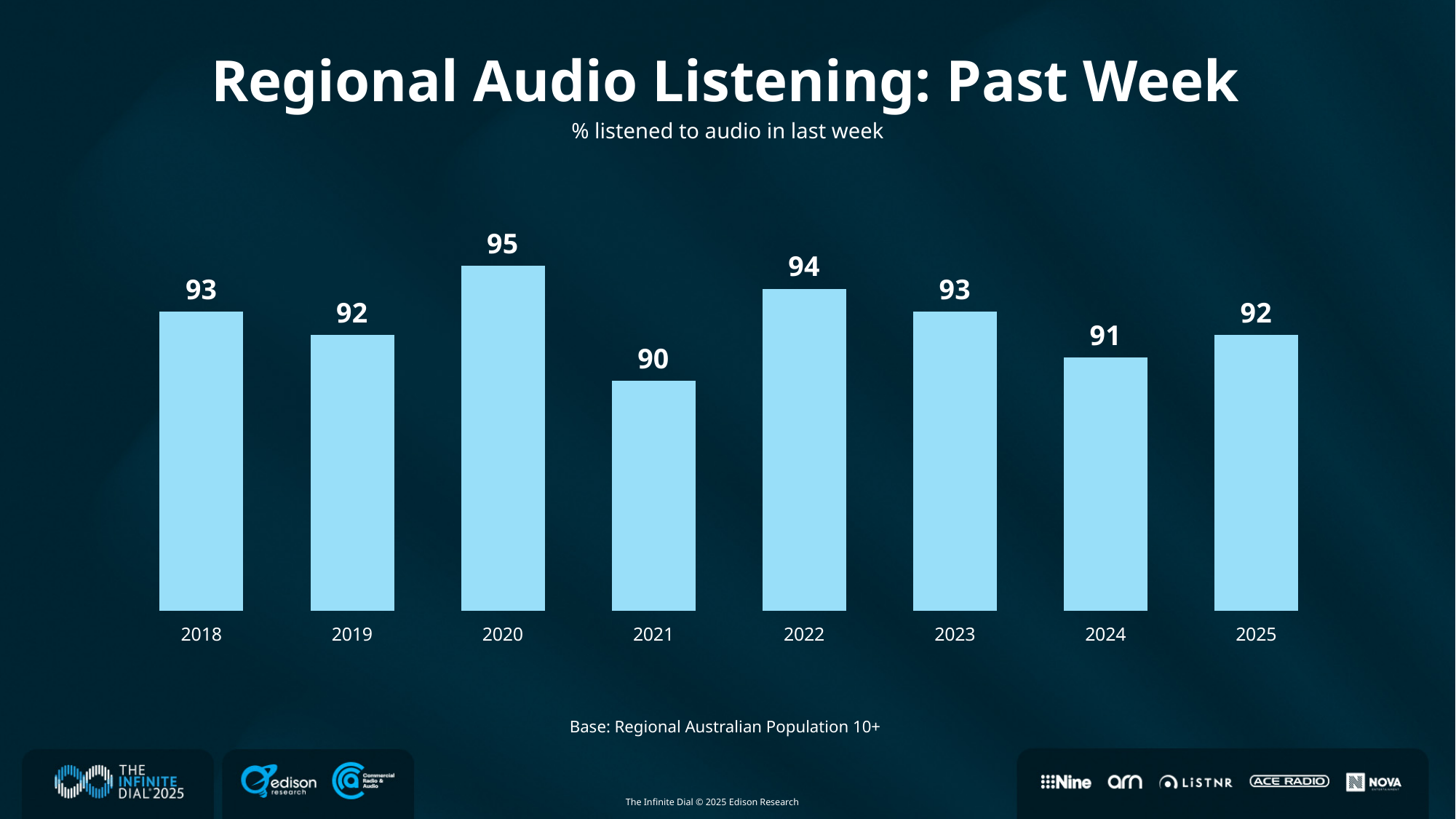
What is the base population stated below the chart? Regional Australian Population 10+ What is the value for 2020? 95 What kind of chart is shown on the slide? Bar chart What is the value for 2021? 90 What is the title of the chart? Regional Audio Listening: Past Week What is the difference between the values for 2020 and 2021? 5 How many years are shown on the chart? 8 Which is larger, the value for 2022 or the value for 2024? 2022 What is the value for 2025? 92 Did the value rise or fall from 2024 to 2025? Rise Which year has the lowest value? 2021 Which year has the highest value? 2020